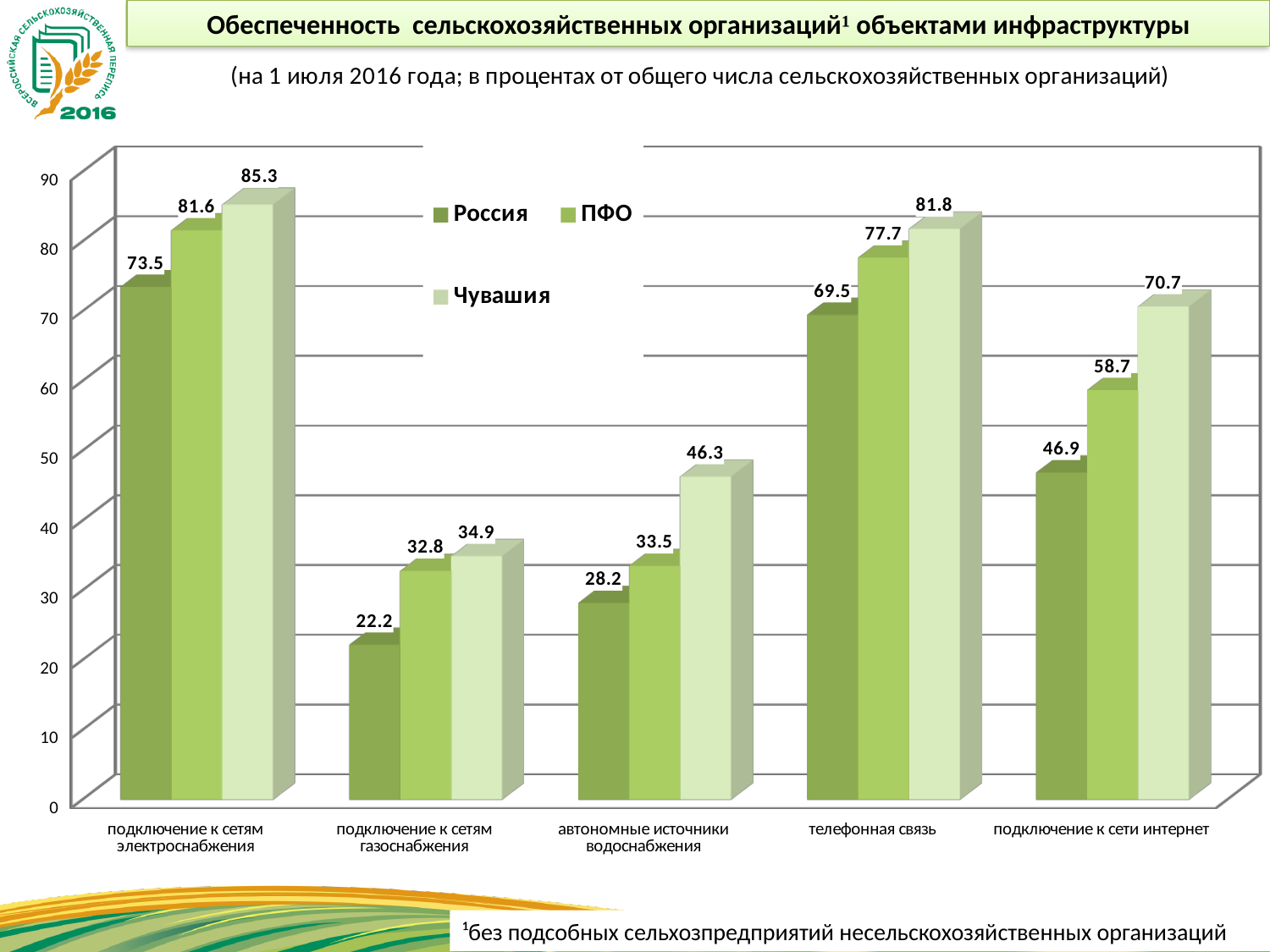
Is the value for Россия in the category телефонная связь greater or less than 60? greater How many categories are shown on the x axis? 5 What is the value for Чувашия in the category подключение к сетям электроснабжения? 85.3 Which is larger in the category автономные источники водоснабжения: the value for ПФО or the value for Чувашия? Чувашия What are the three series listed in the legend? Россия, ПФО, Чувашия Which category has the highest value for Россия? подключение к сетям электроснабжения How many series does the legend list? 3 What kind of chart is shown on the slide? bar chart What is the value for ПФО in the category телефонная связь? 77.7 What is the value for Россия in the category подключение к сетям газоснабжения? 22.2 What is the difference between the Чувашия and Россия values for подключение к сети интернет? 23.8 Which category has the lowest value for Чувашия? подключение к сетям газоснабжения